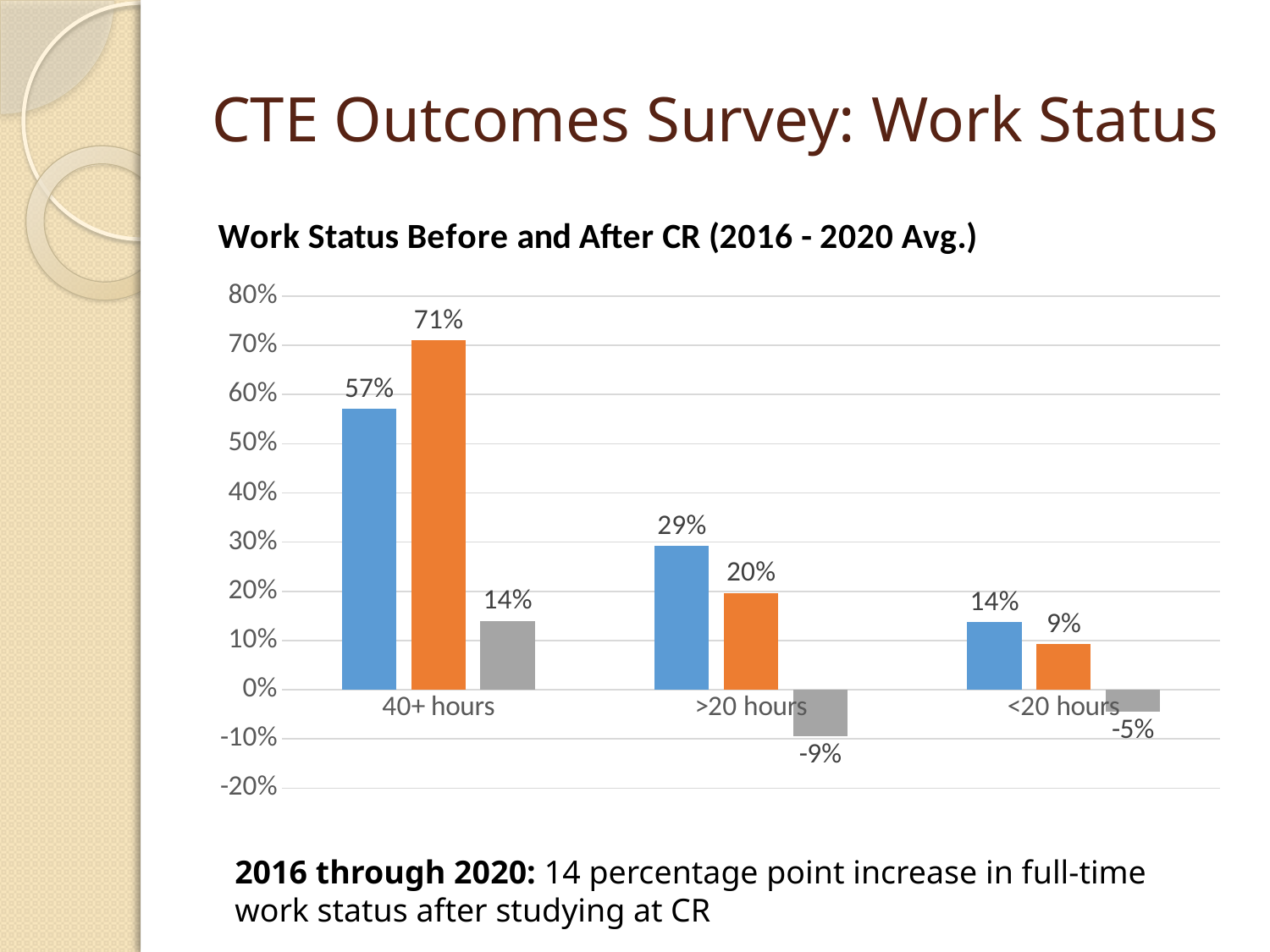
What is the value of the blue bar for 40+ hours? 57% Do the blue bars rise or fall from 40+ hours to <20 hours? fall Which category has the highest orange bar? 40+ hours What kind of chart is shown on the slide? bar chart For >20 hours, which is larger, the blue bar or the orange bar? the blue bar Which category has the lowest blue bar? <20 hours What is the difference between the orange and blue bars for 40+ hours? 14 percentage points What is the title of the chart? Work Status Before and After CR (2016 - 2020 Avg.) What is the value of the gray bar for >20 hours? -9% How many categories are shown on the x axis? 3 What is the value of the orange bar for 40+ hours? 71% What is the value of the orange bar for <20 hours? 9%